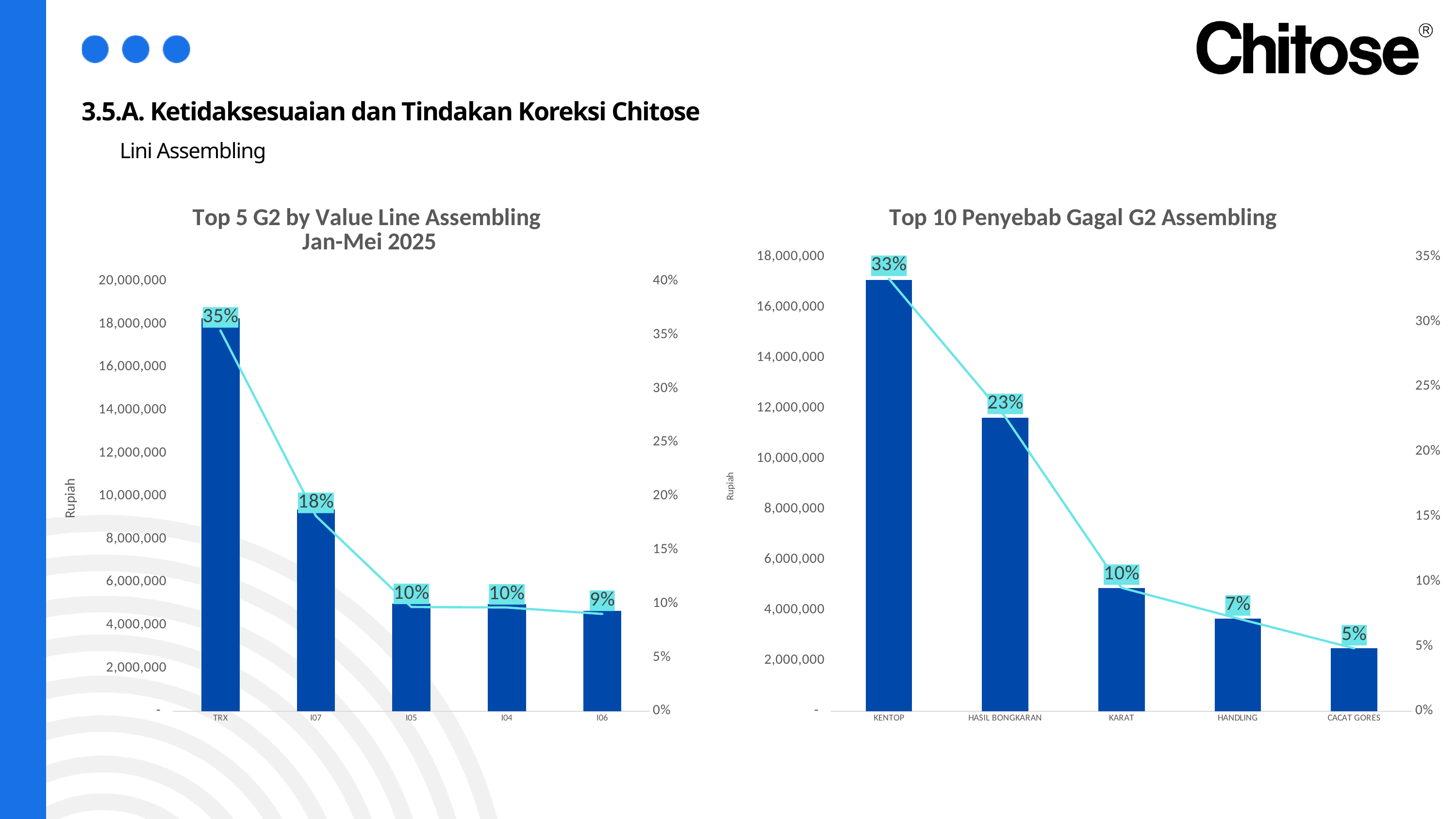
In the 'Top 5 G2 by Value Line Assembling Jan-Mei 2025' chart, which category has the highest bar? TRX In the 'Top 10 Penyebab Gagal G2 Assembling' chart, is the bar for KENTOP greater or less than 16,000,000? greater In the 'Top 5 G2 by Value Line Assembling Jan-Mei 2025' chart, what percentage is labelled for I07? 18% In the 'Top 10 Penyebab Gagal G2 Assembling' chart, which category has the lowest bar? CACAT GORES In the 'Top 10 Penyebab Gagal G2 Assembling' chart, which bar is taller, KARAT or HANDLING? KARAT In the 'Top 5 G2 by Value Line Assembling Jan-Mei 2025' chart, how many categories are shown on the x axis? 5 In the 'Top 10 Penyebab Gagal G2 Assembling' chart, what percentage is labelled for KENTOP? 33% In the 'Top 5 G2 by Value Line Assembling Jan-Mei 2025' chart, is the bar for I07 greater or less than 10,000,000? less In the 'Top 10 Penyebab Gagal G2 Assembling' chart, do the bar values rise or fall from left to right along the x axis? fall In the 'Top 5 G2 by Value Line Assembling Jan-Mei 2025' chart, what is the difference between the percentage labels for TRX and I07? 17% In the 'Top 5 G2 by Value Line Assembling Jan-Mei 2025' chart, what percentage is labelled for TRX? 35% In the 'Top 10 Penyebab Gagal G2 Assembling' chart, what percentage is labelled for HASIL BONGKARAN? 23%